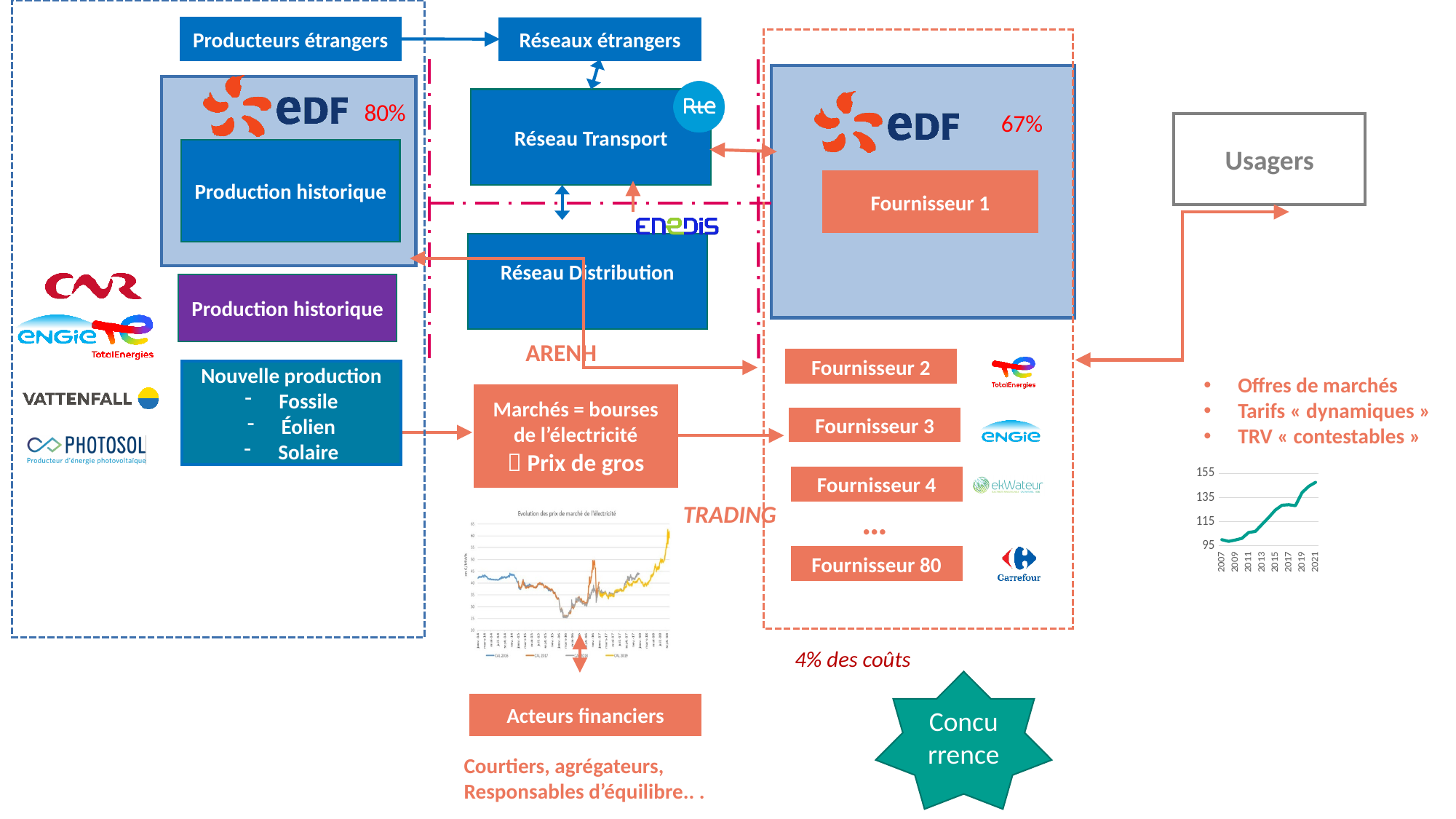
In the chart on the right of the slide, is the value for 2021 greater or less than 135? greater In the chart on the right of the slide, what is the highest value shown on the y axis? 155 In the chart on the right of the slide, is the value for 2007 greater or less than 115? less How many series does the legend of the chart 'Evolution des prix de marché de l'électricité' list? 4 In the chart on the right of the slide (2007–2021), do the values rise or fall along the x axis? rise In the chart 'Evolution des prix de marché de l'électricité', is the lowest point of the line greater or less than 30? less What is the title of the chart at the bottom centre of the slide? Evolution des prix de marché de l'électricité In the chart on the right of the slide, which year has the higher value, 2007 or 2021? 2021 What kind of chart is the chart on the right of the slide, below the bullet list? line chart In the chart on the right of the slide, what is the first year shown on the x axis? 2007 What kind of chart is the chart titled 'Evolution des prix de marché de l'électricité'? line chart